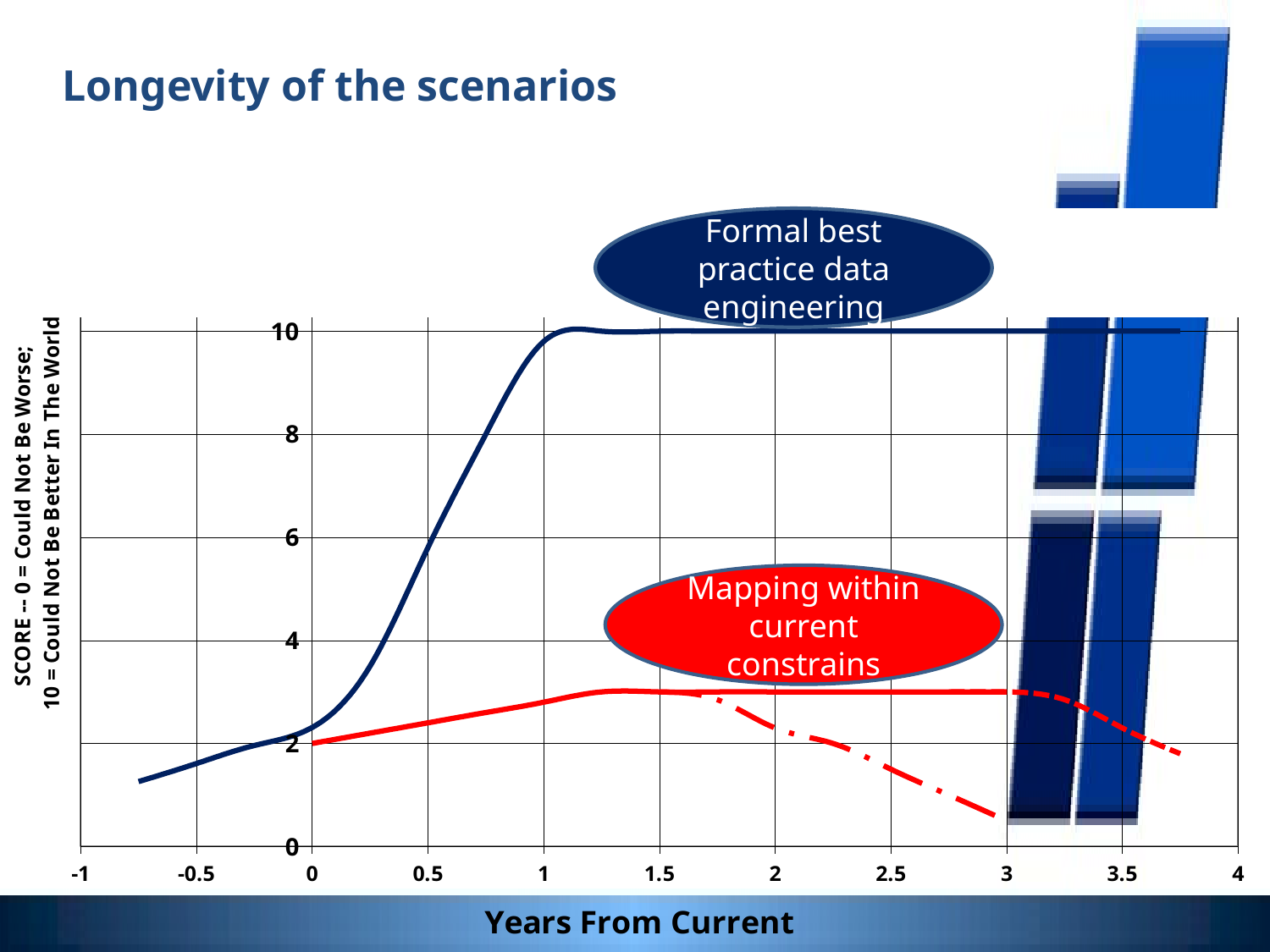
Is the score for the Formal best practice data engineering scenario at 2 years from current greater or less than 8? greater How many scenarios are labelled on the chart? 2 Is the score for the Formal best practice data engineering scenario at 0 years from current greater or less than 4? less What is the label of the x axis? Years From Current Is the score for the Mapping within current constrains scenario at 3 years from current greater or less than 4? less What kind of chart is shown on the slide? line chart What is the title of the chart on the slide? Longevity of the scenarios Does the score for the Formal best practice data engineering scenario rise or fall between 0 and 1 years from current? rise At 2 years from current, which scenario has the higher score? Formal best practice data engineering Does the dash-dot line for the Mapping within current constrains scenario rise or fall between 2 and 3 years from current? fall